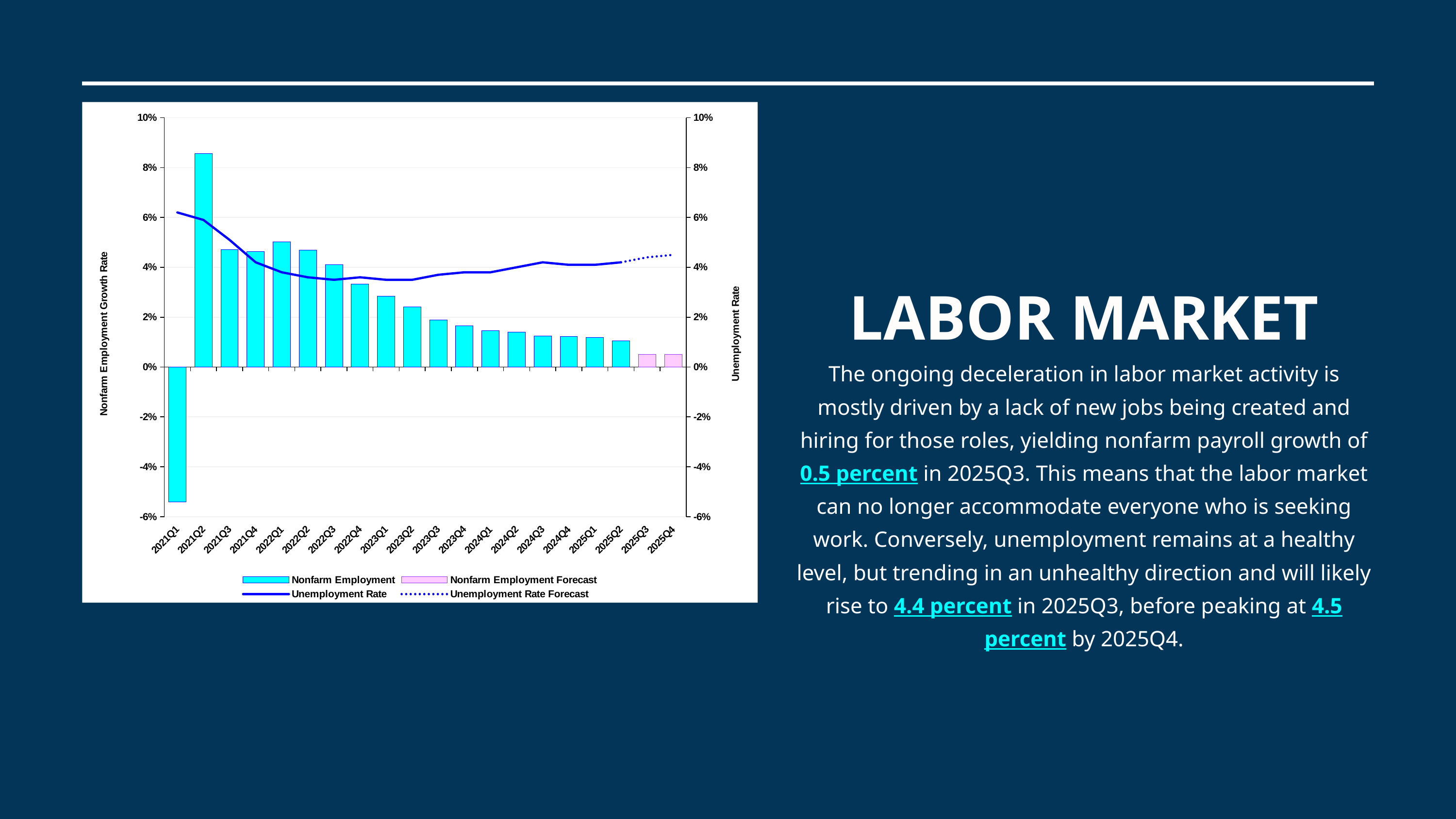
Which quarter has the highest Nonfarm Employment growth rate bar? 2021Q2 Which legend entry is drawn as a dotted line? Unemployment Rate Forecast How many quarters are shown along the x axis of the chart? 20 How many series does the chart legend list? 4 Which has the larger Nonfarm Employment growth rate, 2022Q1 or 2023Q1? 2022Q1 Is the Nonfarm Employment growth rate for 2021Q1 greater or less than -4%? less Is the Unemployment Rate for 2023Q2 greater or less than 4%? less What kind of chart is shown on the slide? A combined bar and line chart Do the Nonfarm Employment bars generally rise or fall from 2021Q2 to 2025Q2? fall What is the label of the right-hand vertical axis of the chart? Unemployment Rate Which quarter has the lowest Nonfarm Employment growth rate bar? 2021Q1 Is the Nonfarm Employment growth rate for 2021Q2 greater or less than 8%? greater